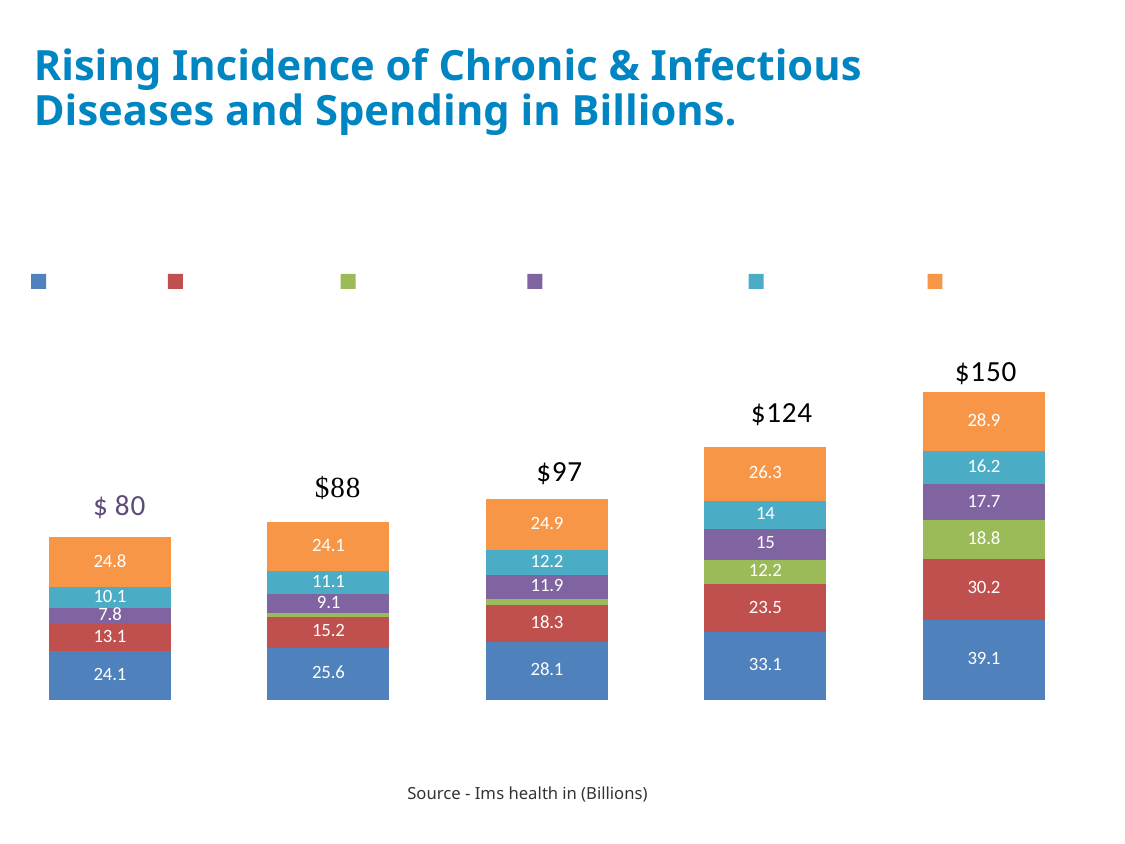
What is the difference between the total of the rightmost bar and the total of the leftmost bar? $70 How many bars are plotted in the chart? 5 Which is larger: the blue segment of the fourth bar or the red segment of the fifth bar? The blue segment of the fourth bar (33.1) What is the value of the blue segment in the rightmost bar? 39.1 What is the value of the red segment in the third bar from the left? 18.3 Which bar has the highest total? The rightmost bar ($150) Which bar has the lowest total? The leftmost bar ($80) How many series does the legend list? 6 What is the total printed above the rightmost bar? $150 What kind of chart is shown on the slide? Stacked bar chart What is the total printed above the leftmost bar? $ 80 What is the value of the orange segment in the leftmost bar? 24.8